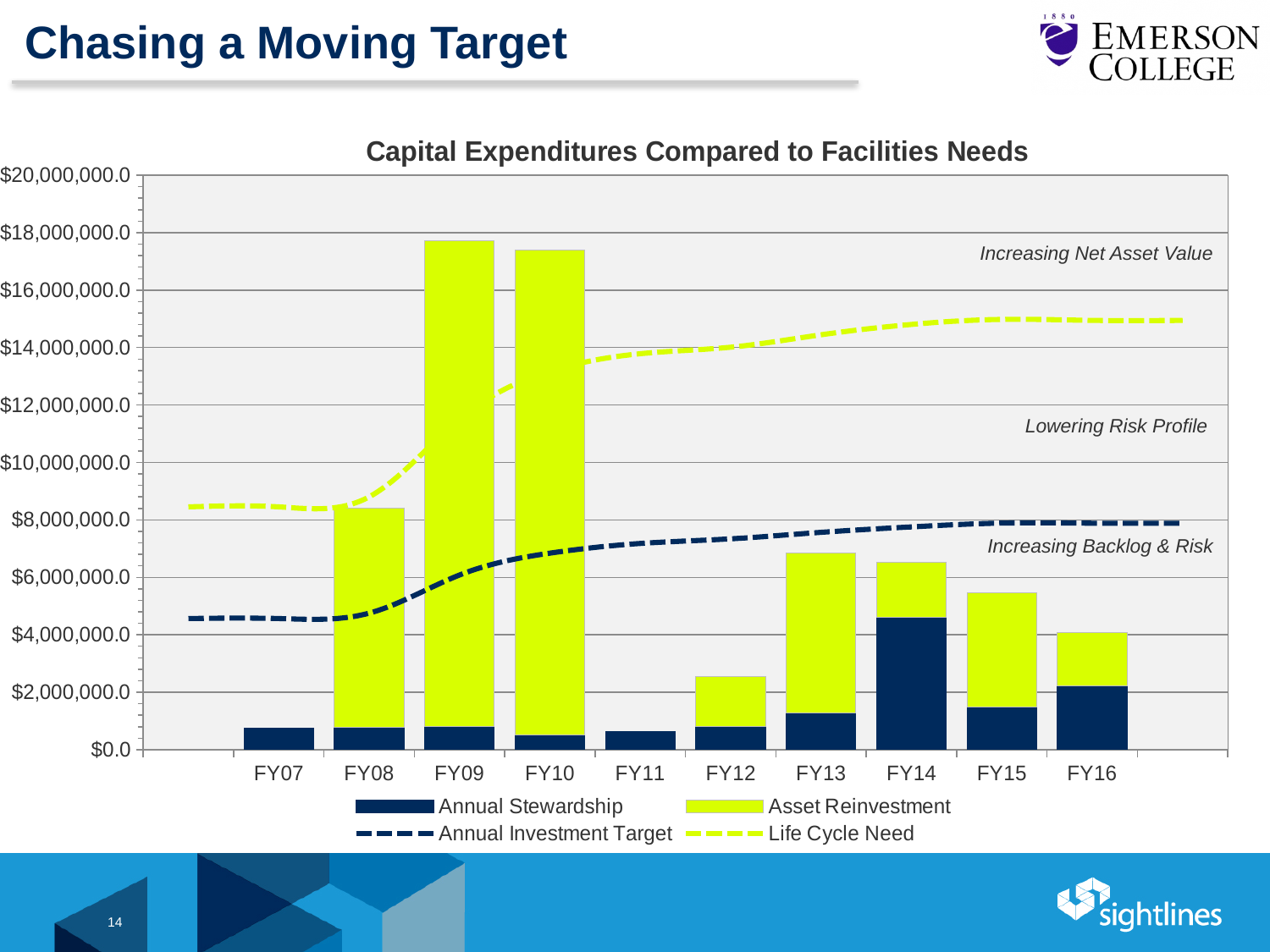
What is the title of the chart? Capital Expenditures Compared to Facilities Needs Is the total stacked bar for FY09 greater or less than $16,000,000? greater What kind of chart is used to show Annual Stewardship and Asset Reinvestment? Stacked bar chart Is the total stacked bar for FY12 greater or less than $4,000,000? less Does the Life Cycle Need line rise or fall from FY07 to FY16? rise Which has the larger total stacked bar, FY13 or FY16? FY13 How many series does the legend list? 4 Which fiscal year has the tallest stacked bar? FY09 Is the Annual Stewardship value for FY14 greater or less than $4,000,000? greater How many fiscal years are shown on the x axis? 10 Which fiscal year has the larger Annual Stewardship value, FY14 or FY15? FY14